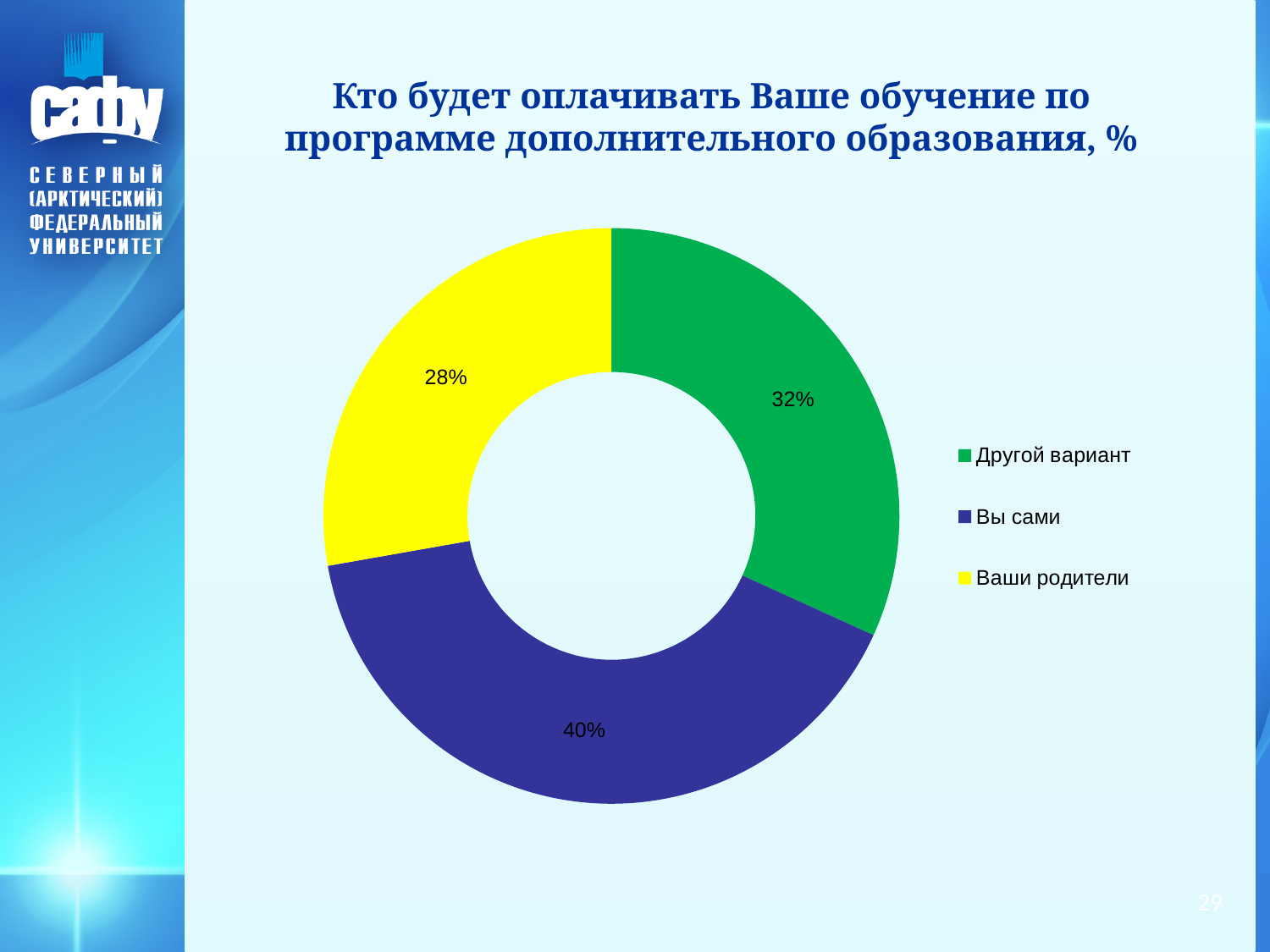
Which is larger: the share for "Другой вариант" or for "Ваши родители"? Другой вариант Which category has the largest share? Вы сами How many categories does the chart show? 3 What colour is the slice for "Ваши родители"? Yellow What is the difference between the shares for "Вы сами" and "Ваши родители"? 12% What is the value for "Другой вариант"? 32% What type of chart is shown on the slide? Doughnut (pie) chart What is the difference between the shares for "Другой вариант" and "Ваши родители"? 4% What is the title of the chart? Кто будет оплачивать Ваше обучение по программе дополнительного образования, % Which category has the smallest share? Ваши родители What is the value for "Ваши родители"? 28% What is the value for "Вы сами"? 40%